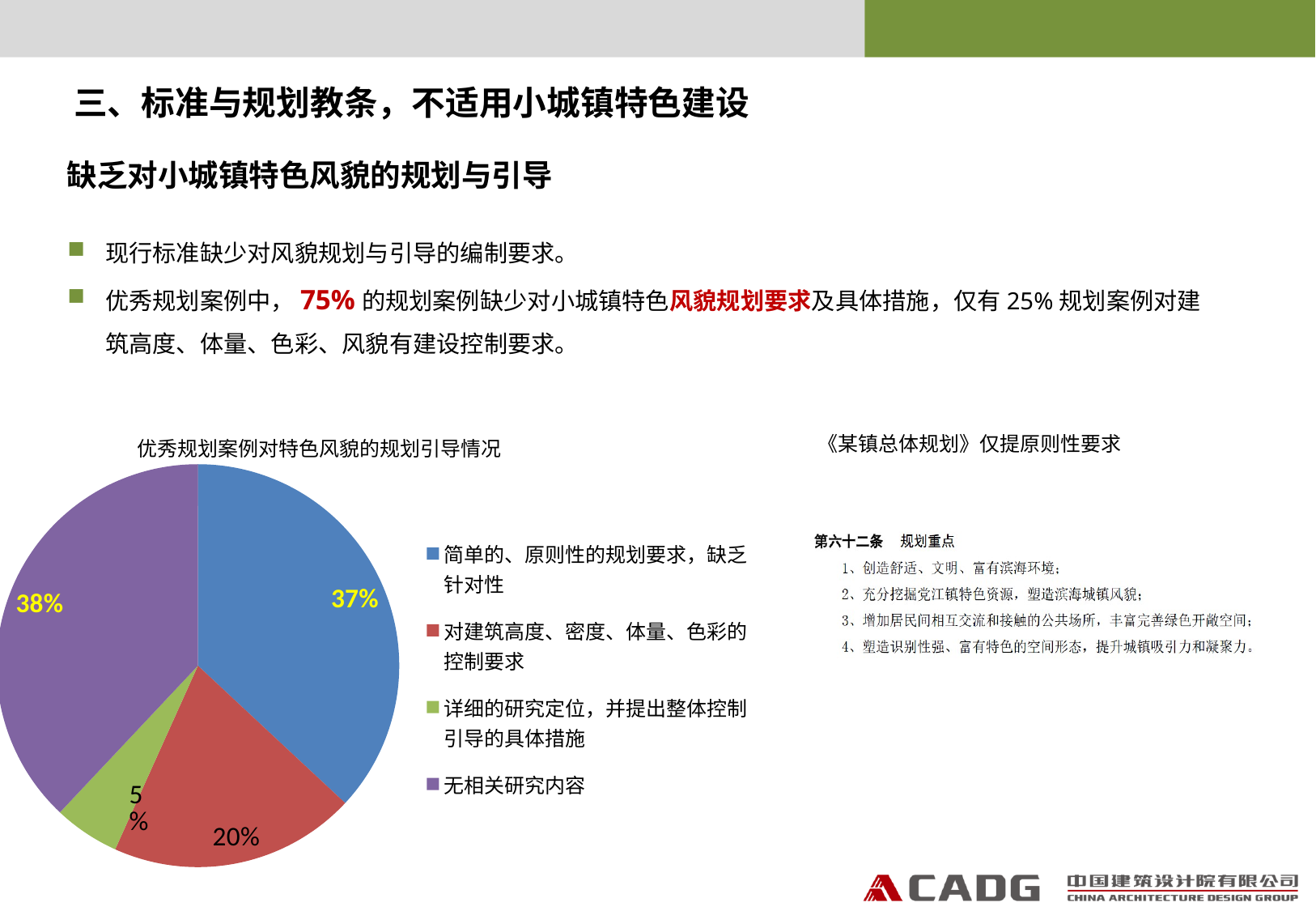
What colour is the slice for 无相关研究内容? purple How many slices does the pie chart have? 4 What share of the pie is labelled 无相关研究内容? 38% What is the title of the pie chart? 优秀规划案例对特色风貌的规划引导情况 What kind of chart is shown on the slide? pie chart What is the difference in percentage points between the 对建筑高度、密度、体量、色彩的控制要求 slice and the 详细的研究定位，并提出整体控制引导的具体措施 slice? 15 Which category has the largest slice of the pie? 无相关研究内容 What share of the pie is labelled 对建筑高度、密度、体量、色彩的控制要求? 20% What share of the pie is labelled 详细的研究定位，并提出整体控制引导的具体措施? 5% Which is larger: the slice for 对建筑高度、密度、体量、色彩的控制要求 or the slice for 详细的研究定位，并提出整体控制引导的具体措施? 对建筑高度、密度、体量、色彩的控制要求 Which category has the smallest slice of the pie? 详细的研究定位，并提出整体控制引导的具体措施 What share of the pie is labelled 简单的、原则性的规划要求，缺乏针对性? 37%